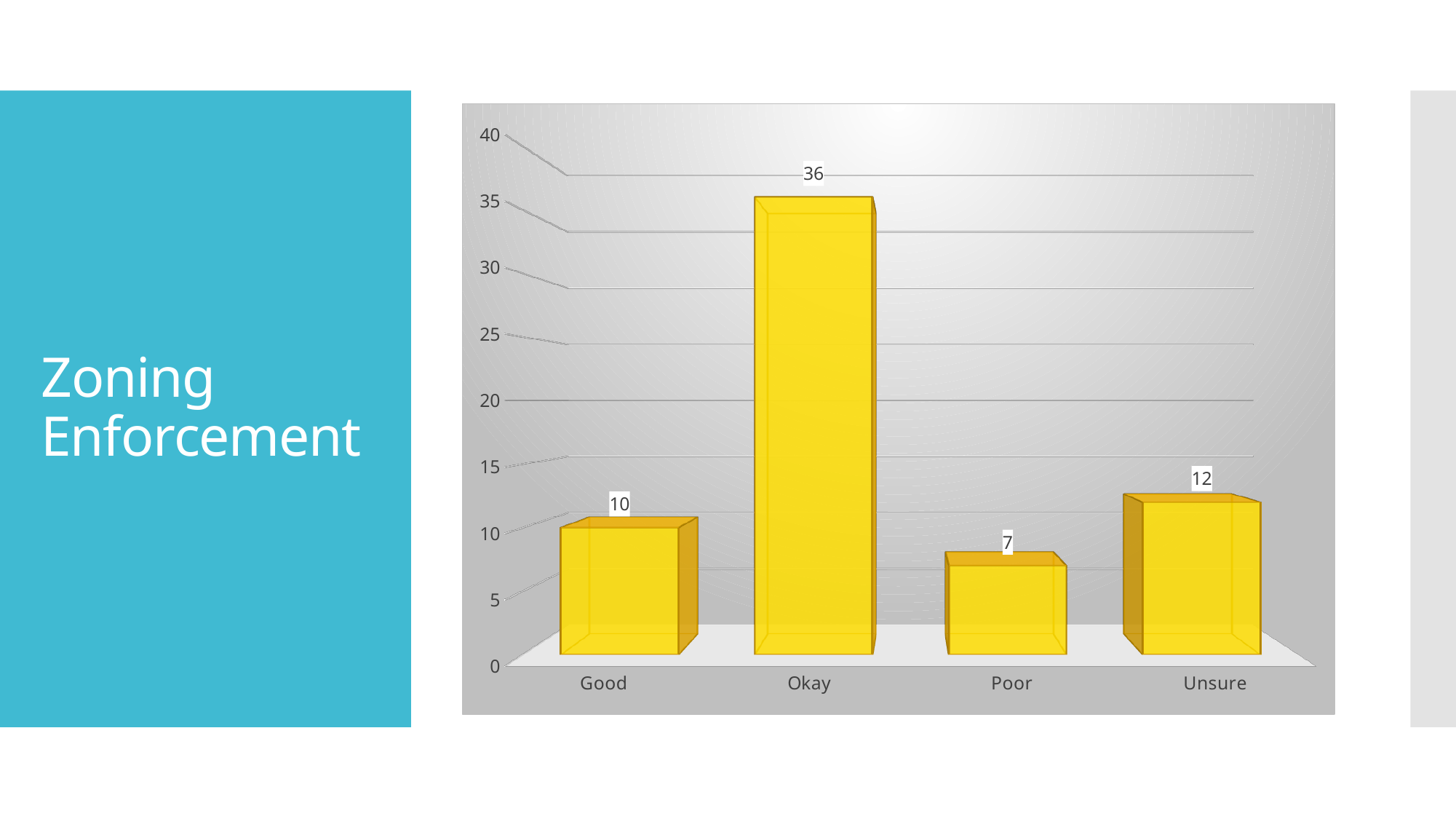
Which is larger, the value for Good or the value for Unsure? Unsure What is the value for Good? 10 How many categories are shown on the x axis? 4 What is the value for Unsure? 12 What is the value for Okay? 36 Is the value for Okay greater or less than 30? greater Which category has the lowest value? Poor Which category has the highest value? Okay What kind of chart is shown on the slide? bar chart What is the difference between the values for Okay and Unsure? 24 What is the difference between the values for Good and Poor? 3 What is the value for Poor? 7